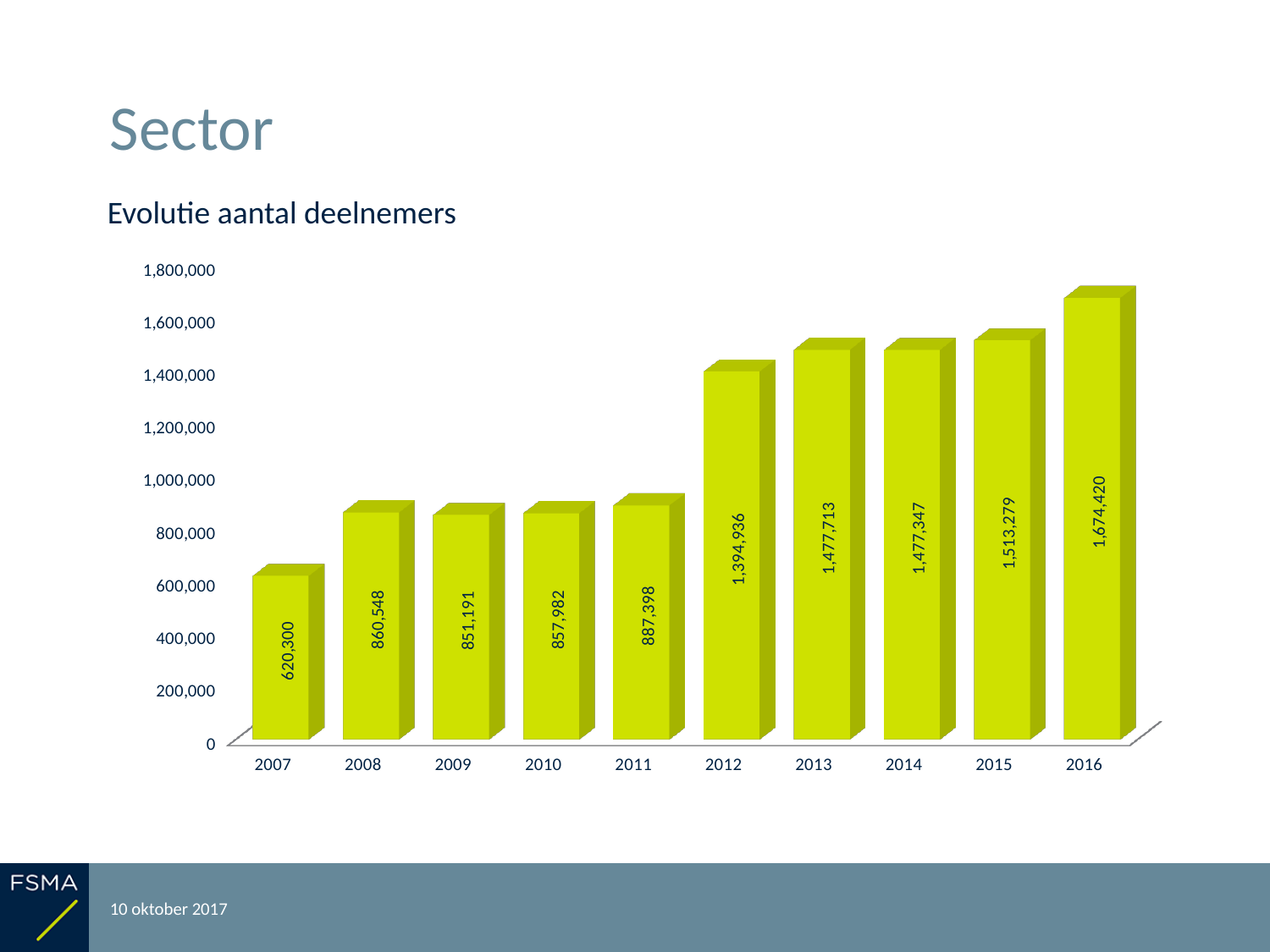
How many years are shown on the x axis? 10 Is the value for 2013 greater or less than 1,200,000? greater What is the value for 2007? 620,300 What is the value for 2016? 1,674,420 Which year has the highest value? 2016 What is the title of the chart? Evolutie aantal deelnemers Which year has the lowest value? 2007 What is the difference between the values for 2016 and 2015? 161,141 Which is larger, the value for 2011 or the value for 2012? 2012 What is the difference between the values for 2012 and 2011? 507,538 What kind of chart is shown on the slide? bar chart What is the value for 2012? 1,394,936